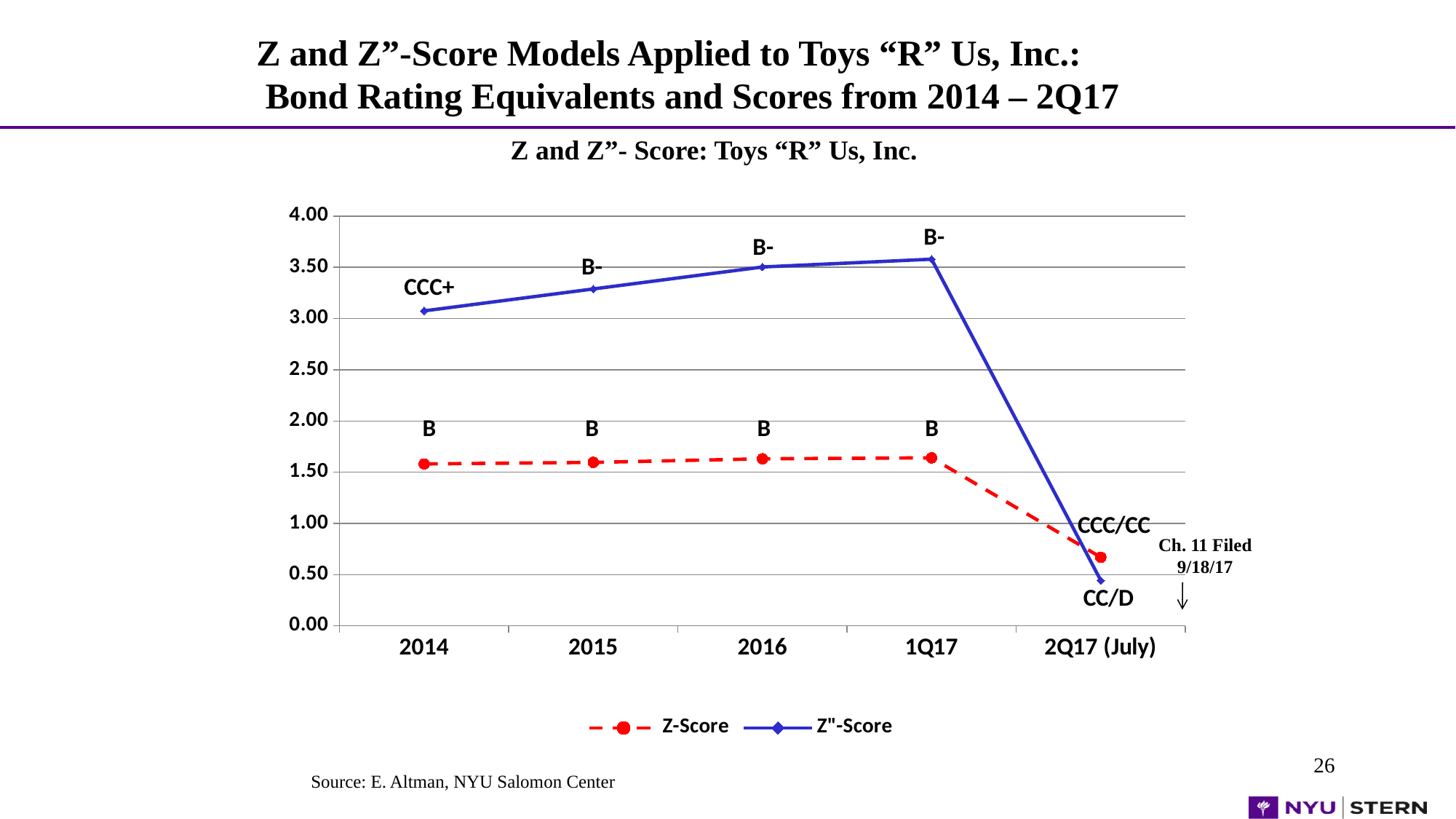
Is the Z"-Score value for 2Q17 (July) greater or less than 1.00? less How many time periods are plotted along the x axis? 5 Which series has the higher value in 2016, Z-Score or Z"-Score? Z"-Score Does the Z"-Score rise or fall from 2014 to 1Q17? Rise What bond rating equivalent is labelled for the Z"-Score in 2Q17 (July)? CC/D What bond rating equivalent is labelled for the Z-Score in 2Q17 (July)? CCC/CC What bond rating equivalent is labelled for the Z-Score in 1Q17? B What bond rating equivalent is labelled for the Z"-Score in 2014? CCC+ In which period is the Z"-Score at its lowest? 2Q17 (July) Is the Z"-Score value for 2016 greater or less than 3.00? greater How many series does the legend list? 2 What kind of chart is shown on the slide? Line chart